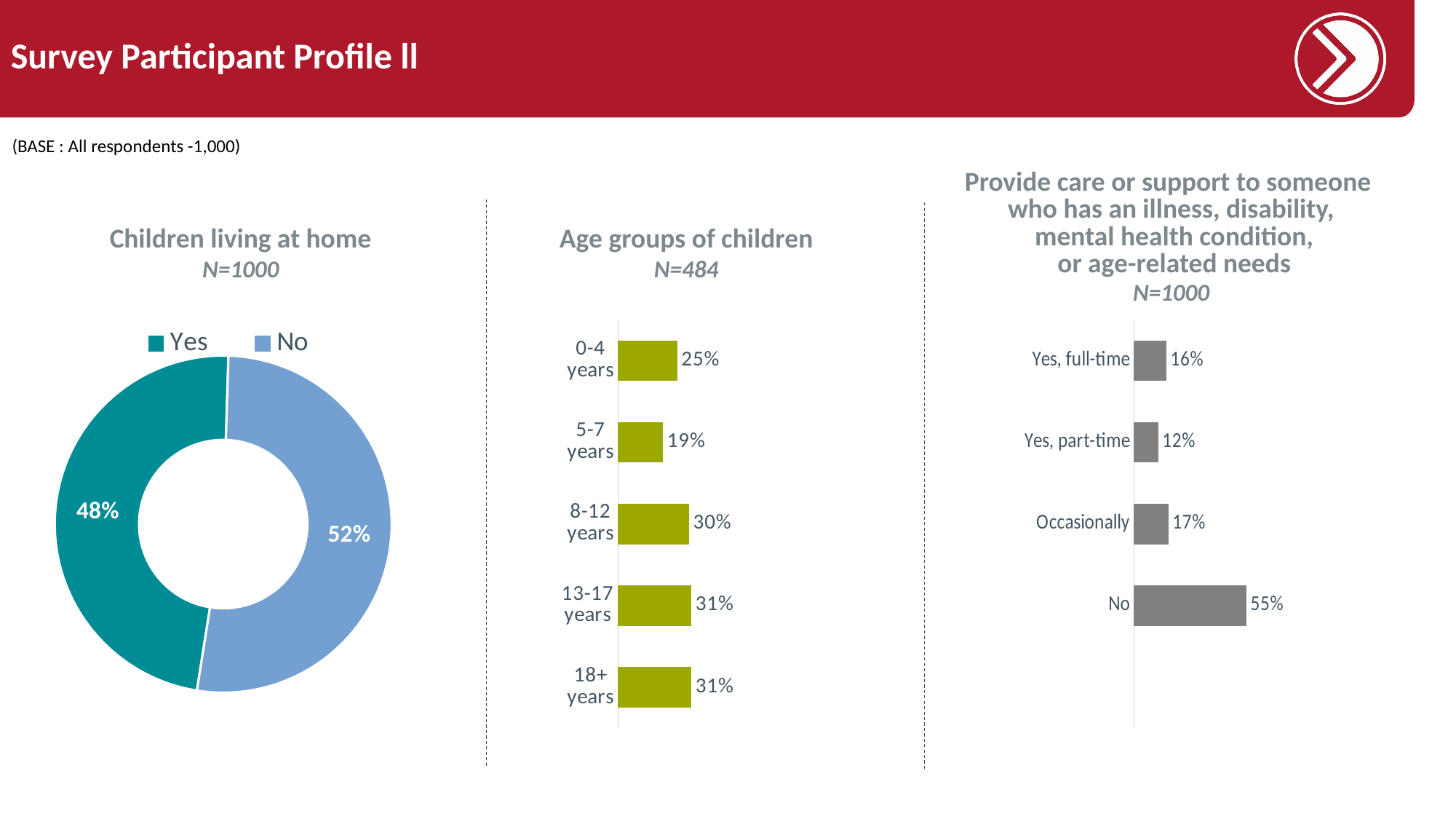
In the 'Age groups of children' chart, what is the difference between 8-12 years and 0-4 years? 5% What kind of chart is the 'Provide care or support' chart? Bar chart In the 'Provide care or support' chart, what is the value for 'Yes, part-time'? 12% How many age groups are shown in the 'Age groups of children' chart? 5 In the 'Age groups of children' chart, which age group has the lowest value? 5-7 years What kind of chart is the 'Children living at home' chart? Doughnut chart In the 'Children living at home' chart, what percentage of respondents answered Yes? 48% In the 'Age groups of children' chart, what is the value for 5-7 years? 19% In the 'Children living at home' chart, which is larger, Yes or No? No In the 'Provide care or support' chart, what is the difference between 'No' and 'Occasionally'? 38% In the 'Children living at home' chart, what percentage of respondents answered No? 52% In the 'Provide care or support' chart, which category has the highest value? No